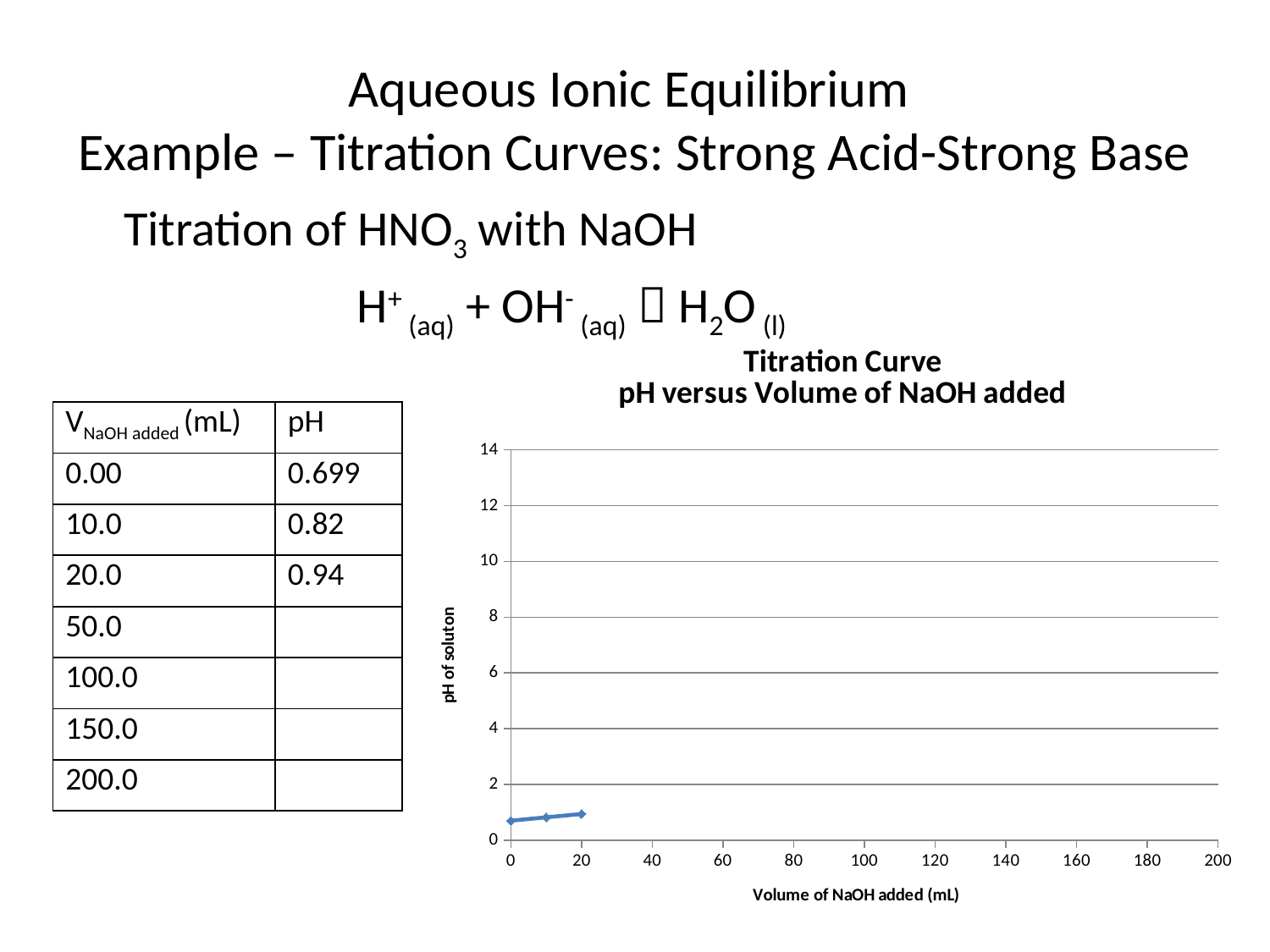
Is the pH value plotted at 0 mL of NaOH added greater or less than 2? less What is the title of the chart? Titration Curve pH versus Volume of NaOH added What kind of chart is the Titration Curve chart? line chart Which is larger, the pH at 10.0 mL of NaOH added or the pH at 20.0 mL of NaOH added? 20.0 mL What is the label of the x axis of the chart? Volume of NaOH added (mL) Is the pH value plotted at 20 mL of NaOH added greater or less than 2? less At which volume of NaOH added is the plotted pH highest? 20 mL How many data points are plotted on the Titration Curve chart? 3 Do the plotted pH values rise or fall as the volume of NaOH added increases? rise What is the pH of the solution when 0.00 mL of NaOH has been added? 0.699 What is the pH of the solution when 20.0 mL of NaOH has been added? 0.94 At which volume of NaOH added is the plotted pH lowest? 0 mL